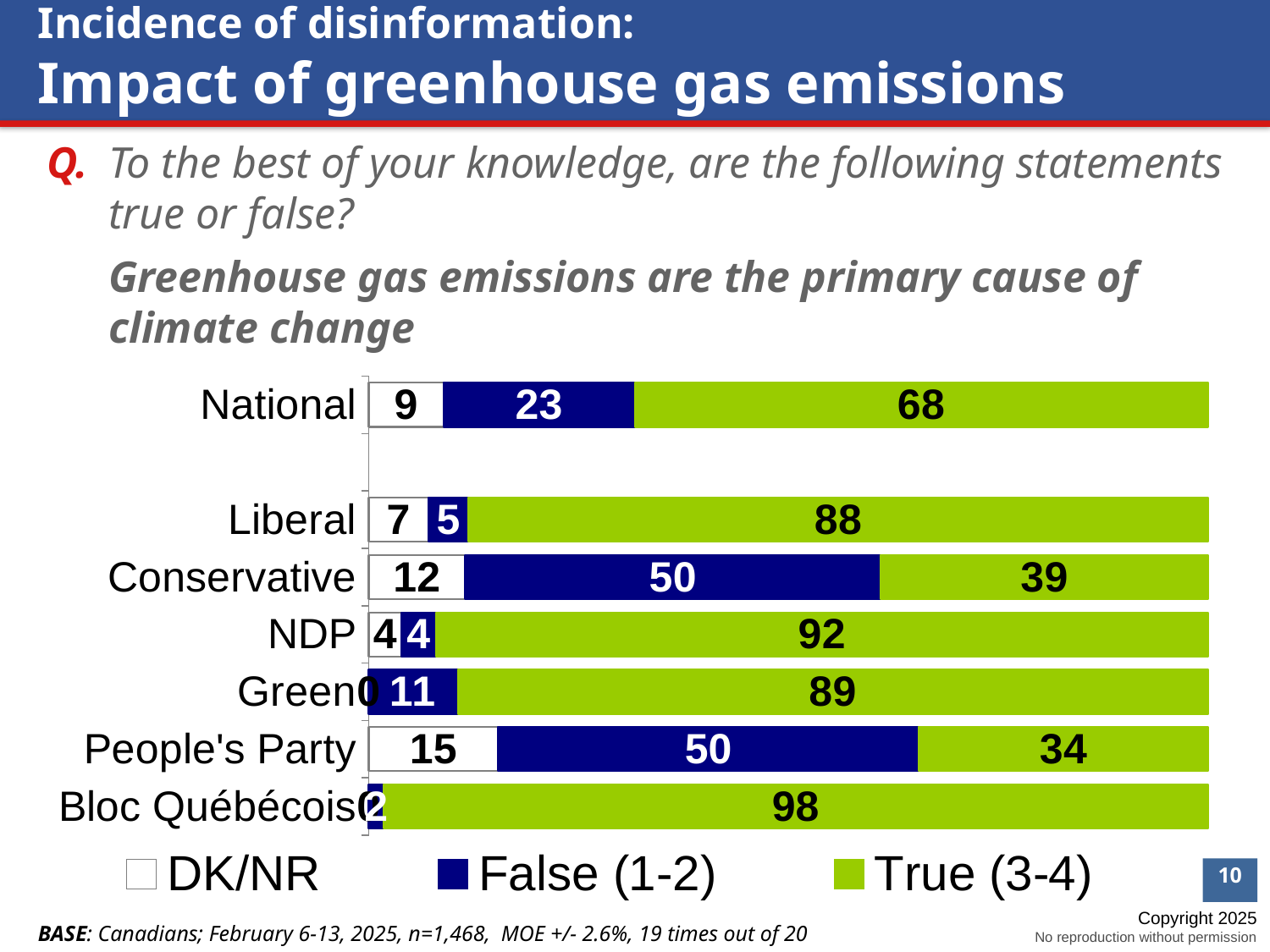
Which is larger, the False (1-2) value for National or for Green? National How many series does the legend list? 3 What percentage of National respondents said the statement is True (3-4)? 68 What is the difference between the True (3-4) values for Liberal and Conservative respondents? 49 What kind of chart is shown on the slide? Stacked bar chart What is the True (3-4) value for Bloc Québécois respondents? 98 What is the DK/NR value for People's Party respondents? 15 Which party group has the lowest True (3-4) value? People's Party What is the False (1-2) value for Conservative respondents? 50 Which party group has the highest True (3-4) value? Bloc Québécois Which legend entry is shown in green? True (3-4) How many categories (rows) are shown in the chart? 7